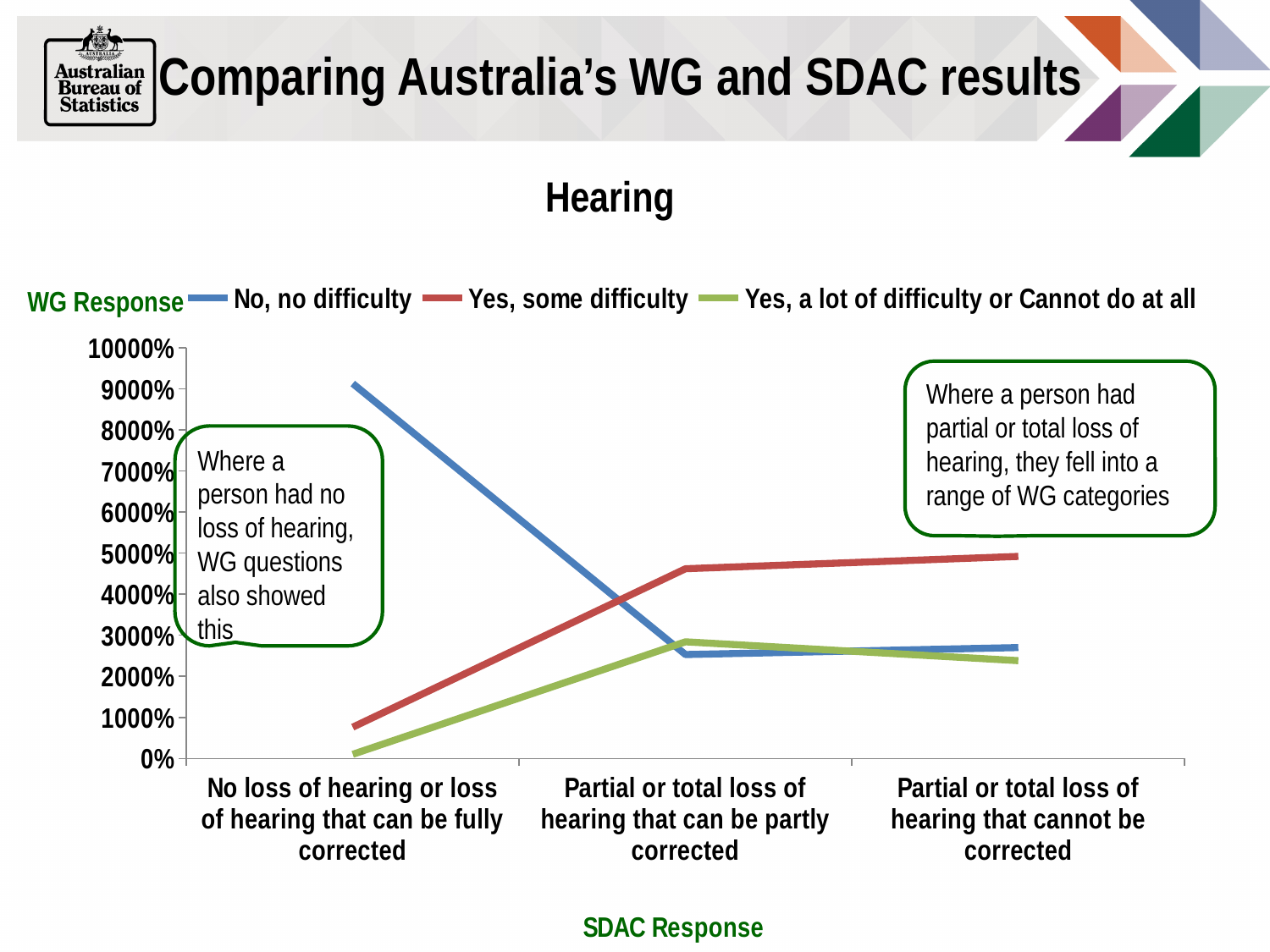
Which series has the lowest value at "No loss of hearing or loss of hearing that can be fully corrected"? Yes, a lot of difficulty or Cannot do at all How many series does the legend list? 3 Does the "Yes, some difficulty" series rise or fall across the SDAC response categories from left to right? rise Is the value for "No, no difficulty" at "Partial or total loss of hearing that can be partly corrected" greater or less than 3000%? less Is the value for "Yes, a lot of difficulty or Cannot do at all" at "No loss of hearing or loss of hearing that can be fully corrected" greater or less than 1000%? less At "Partial or total loss of hearing that cannot be corrected", which is larger: "Yes, some difficulty" or "Yes, a lot of difficulty or Cannot do at all"? Yes, some difficulty Is the value for "Yes, some difficulty" at "Partial or total loss of hearing that cannot be corrected" greater or less than 4000%? greater For which SDAC response category is the "No, no difficulty" series highest? No loss of hearing or loss of hearing that can be fully corrected How many SDAC response categories are shown on the x axis? 3 What kind of chart is shown on the slide? line chart What is the title of the x axis? SDAC Response